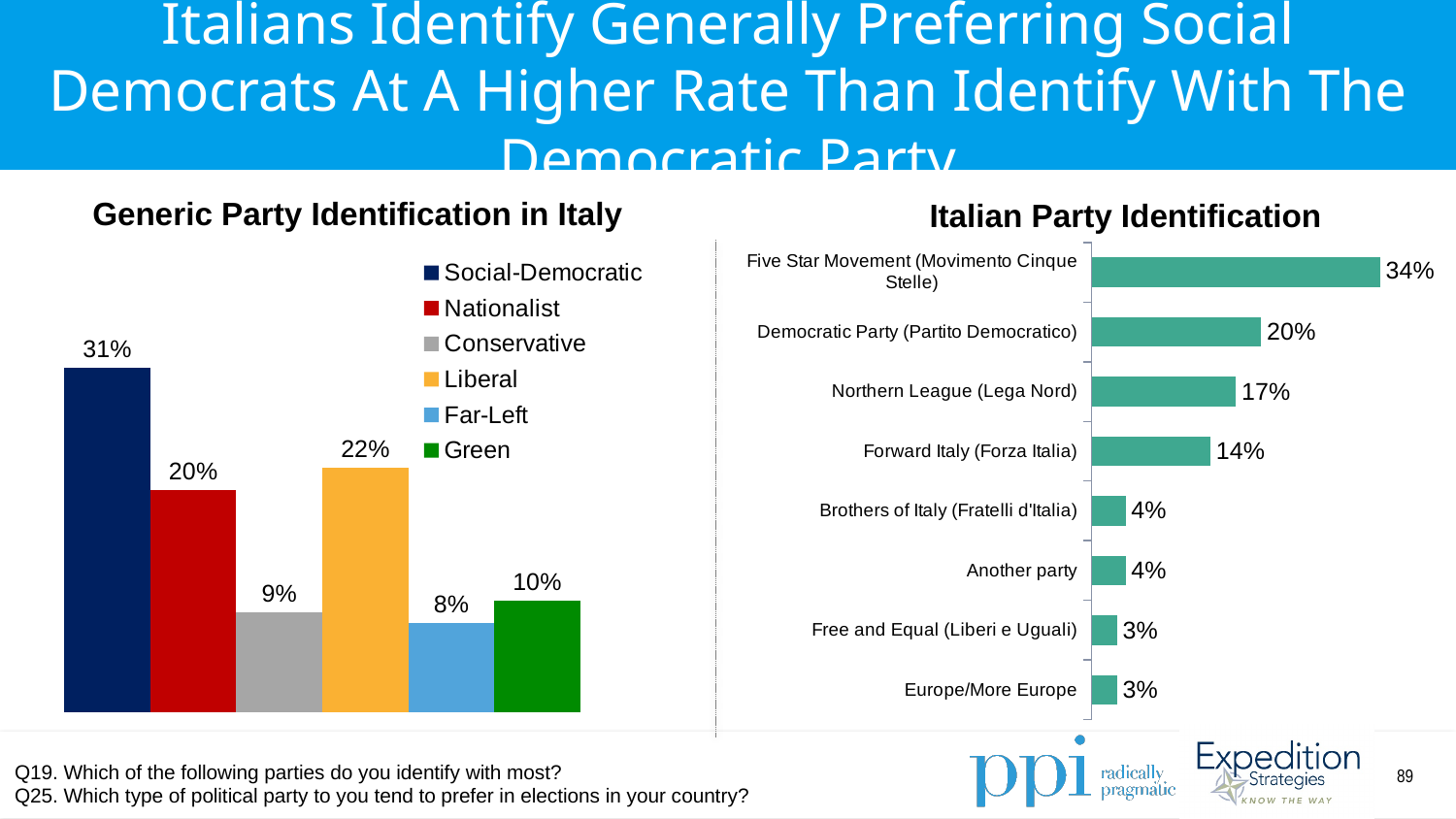
In the 'Italian Party Identification' chart, what is the value for Northern League (Lega Nord)? 17% How many categories are shown in the 'Italian Party Identification' chart? 8 In the 'Generic Party Identification in Italy' chart, what is the value for Social-Democratic? 31% In the 'Italian Party Identification' chart, what is the difference between Five Star Movement and Democratic Party? 14% In the 'Italian Party Identification' chart, which party has the highest value? Five Star Movement (Movimento Cinque Stelle) In the 'Generic Party Identification in Italy' chart, which series has the lowest value? Far-Left In the 'Generic Party Identification in Italy' chart, what is the value for Liberal? 22% In the 'Generic Party Identification in Italy' chart, how many series does the legend list? 6 In the 'Italian Party Identification' chart, which is larger: Forward Italy (Forza Italia) or Brothers of Italy (Fratelli d'Italia)? Forward Italy (Forza Italia) In the 'Generic Party Identification in Italy' chart, what colour is the Liberal bar? Orange What kind of chart is the 'Italian Party Identification' chart? Bar chart In the 'Generic Party Identification in Italy' chart, what is the difference between the Nationalist and Conservative values? 11%